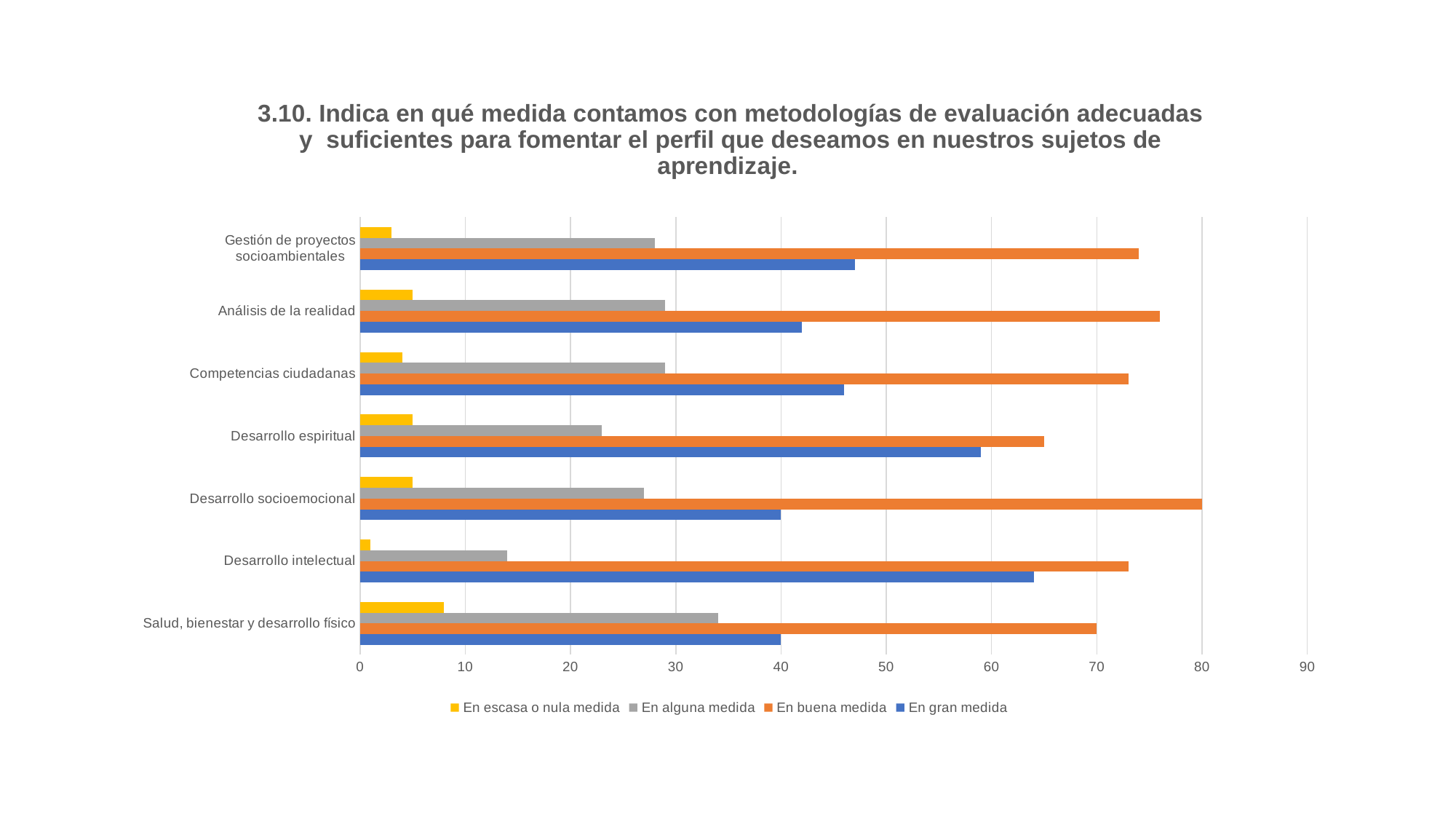
How many series does the legend list? 4 Which category has the highest value for 'En gran medida'? Desarrollo intelectual Which series is shown in orange in the legend? En buena medida Which category has the highest value for 'En buena medida'? Desarrollo socioemocional Is the value of 'En gran medida' for 'Desarrollo espiritual' greater or less than 50? greater What is the value of 'En gran medida' for 'Salud, bienestar y desarrollo físico'? 40 Is the value of 'En alguna medida' for 'Desarrollo intelectual' greater or less than 20? less How many categories are plotted on the chart? 7 What is the value of 'En buena medida' for 'Desarrollo socioemocional'? 80 What kind of chart is shown on the slide? bar chart Which category has the lowest value for 'En alguna medida'? Desarrollo intelectual For 'Desarrollo espiritual', which is larger: 'En buena medida' or 'En gran medida'? En buena medida